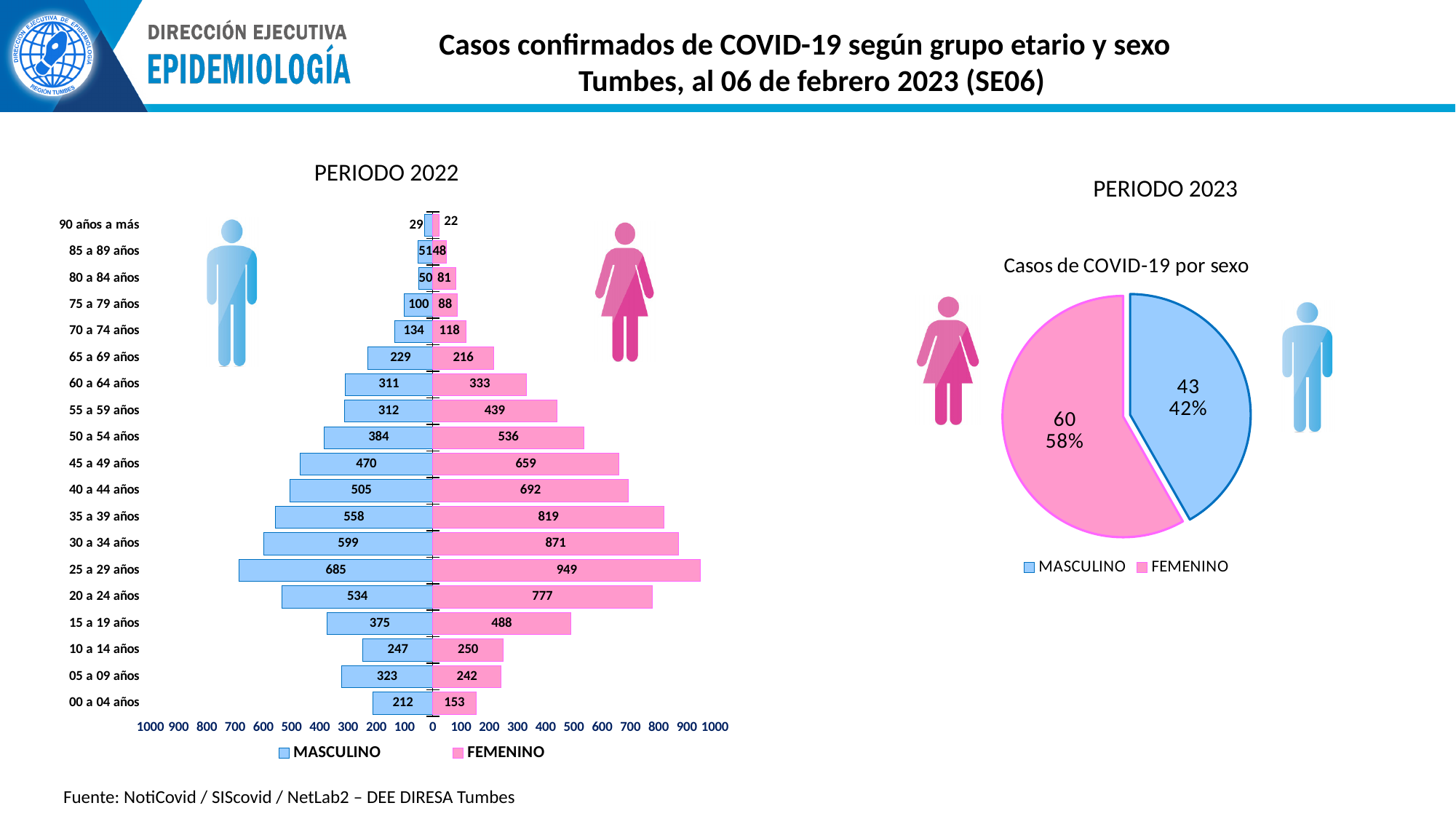
In the PERIODO 2022 chart, how many age groups are plotted? 19 What kind of chart is the PERIODO 2022 chart? Bar chart In the PERIODO 2023 pie chart, what colour is the FEMENINO slice? Pink In the PERIODO 2022 chart, what is the difference between the FEMENINO and MASCULINO values for the 35 a 39 años group? 261 In the PERIODO 2023 pie chart, what is the MASCULINO value? 43 In the PERIODO 2022 chart, how many MASCULINO cases are shown for the 30 a 34 años group? 599 In the PERIODO 2022 chart, which age group has the lowest MASCULINO value? 90 años a más In the PERIODO 2022 chart, which age group has the highest FEMENINO value? 25 a 29 años In the PERIODO 2022 chart, how many FEMENINO cases are shown for the 25 a 29 años group? 949 In the PERIODO 2023 pie chart, what share of cases is FEMENINO? 58% In the PERIODO 2022 chart, which is larger for the 05 a 09 años group, MASCULINO or FEMENINO? MASCULINO In the PERIODO 2022 chart, how many series does the legend list? 2